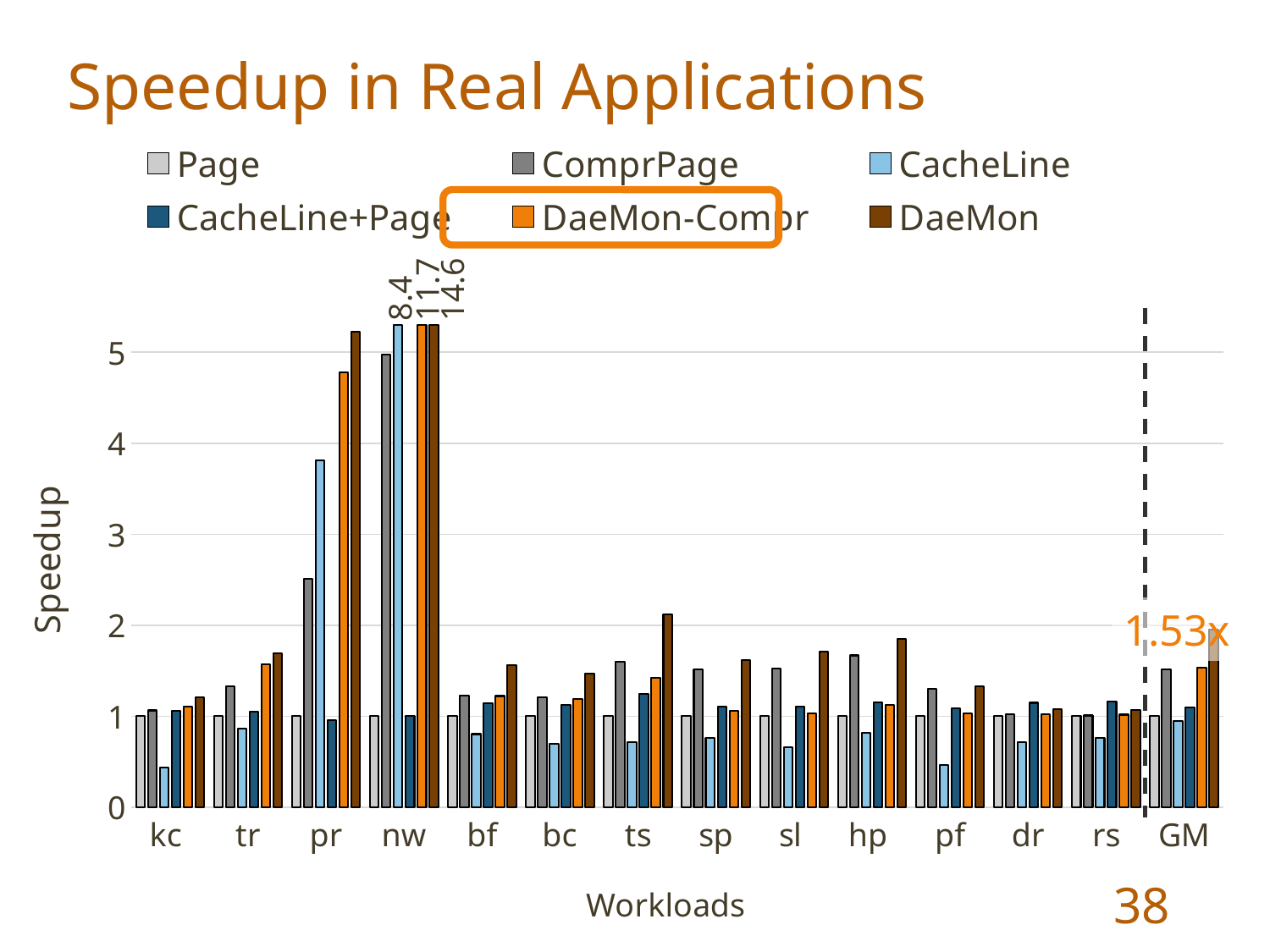
What is the DaeMon-Compr speedup for the nw workload? 11.7 What is the CacheLine speedup for the nw workload? 8.4 Which workload has the highest DaeMon speedup? nw For the pr workload, which is larger: the CacheLine speedup or the ComprPage speedup? CacheLine How many series does the legend list? 6 Is the DaeMon speedup for the ts workload greater or less than 2? greater For the nw workload, what is the difference between the DaeMon and DaeMon-Compr speedups? 2.9 What is the DaeMon speedup for the nw workload? 14.6 What is the title of the y axis? Speedup How many workloads are shown along the x axis? 14 What kind of chart is shown on the slide? bar chart Is the CacheLine speedup for the kc workload greater or less than 1? less